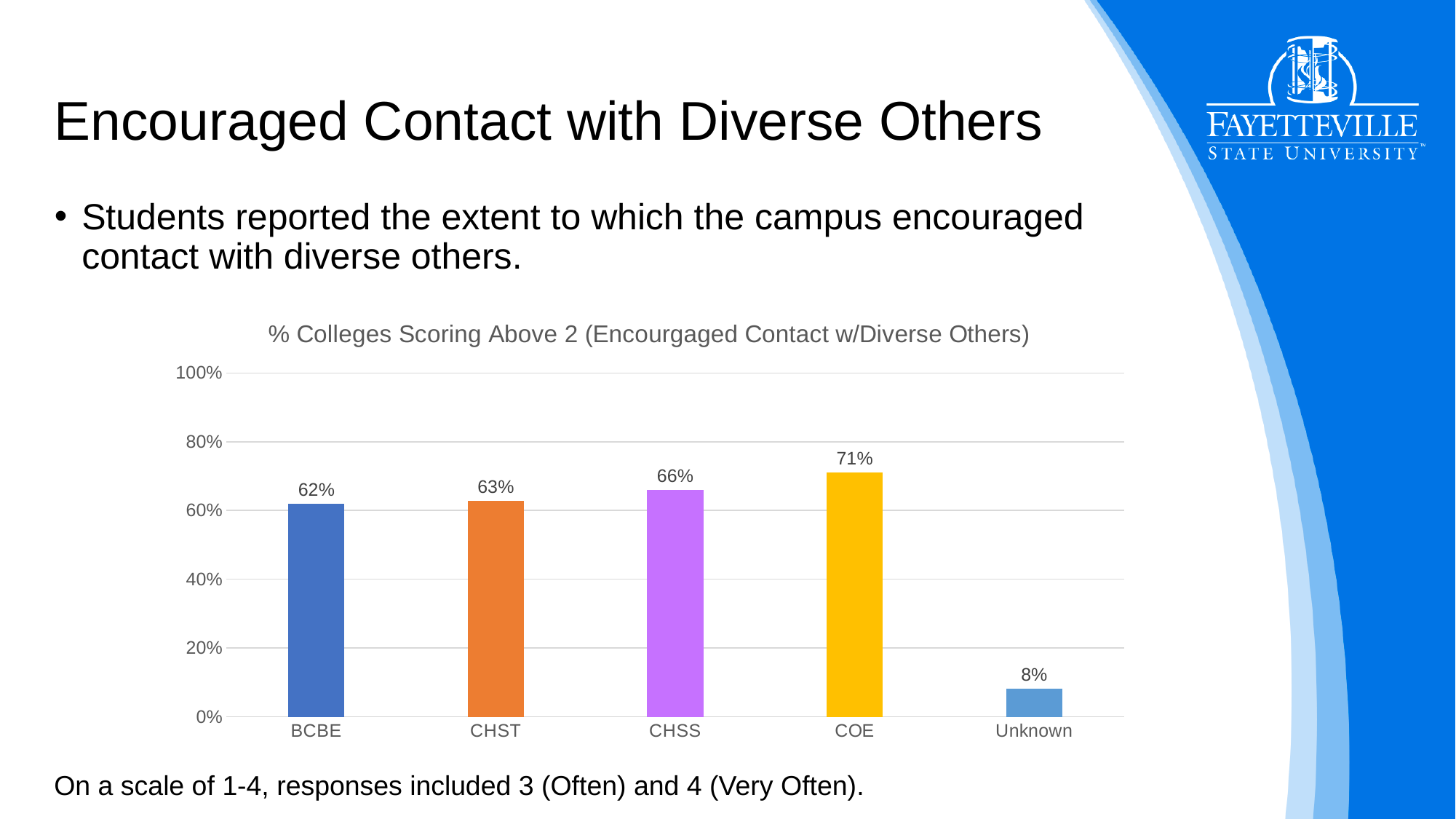
What is the difference between the values for CHST and Unknown? 55% Which category has the highest value? COE What is the title of the chart? % Colleges Scoring Above 2 (Encourgaged Contact w/Diverse Others) What is the value for BCBE? 62% Is the value for CHST greater or less than 80%? less What is the value for Unknown? 8% What kind of chart is shown on the slide? bar chart What is the difference between the values for COE and CHSS? 5% How many categories are shown on the x axis? 5 What is the value for COE? 71% Which is larger, the value for CHSS or the value for BCBE? CHSS Which category has the lowest value? Unknown